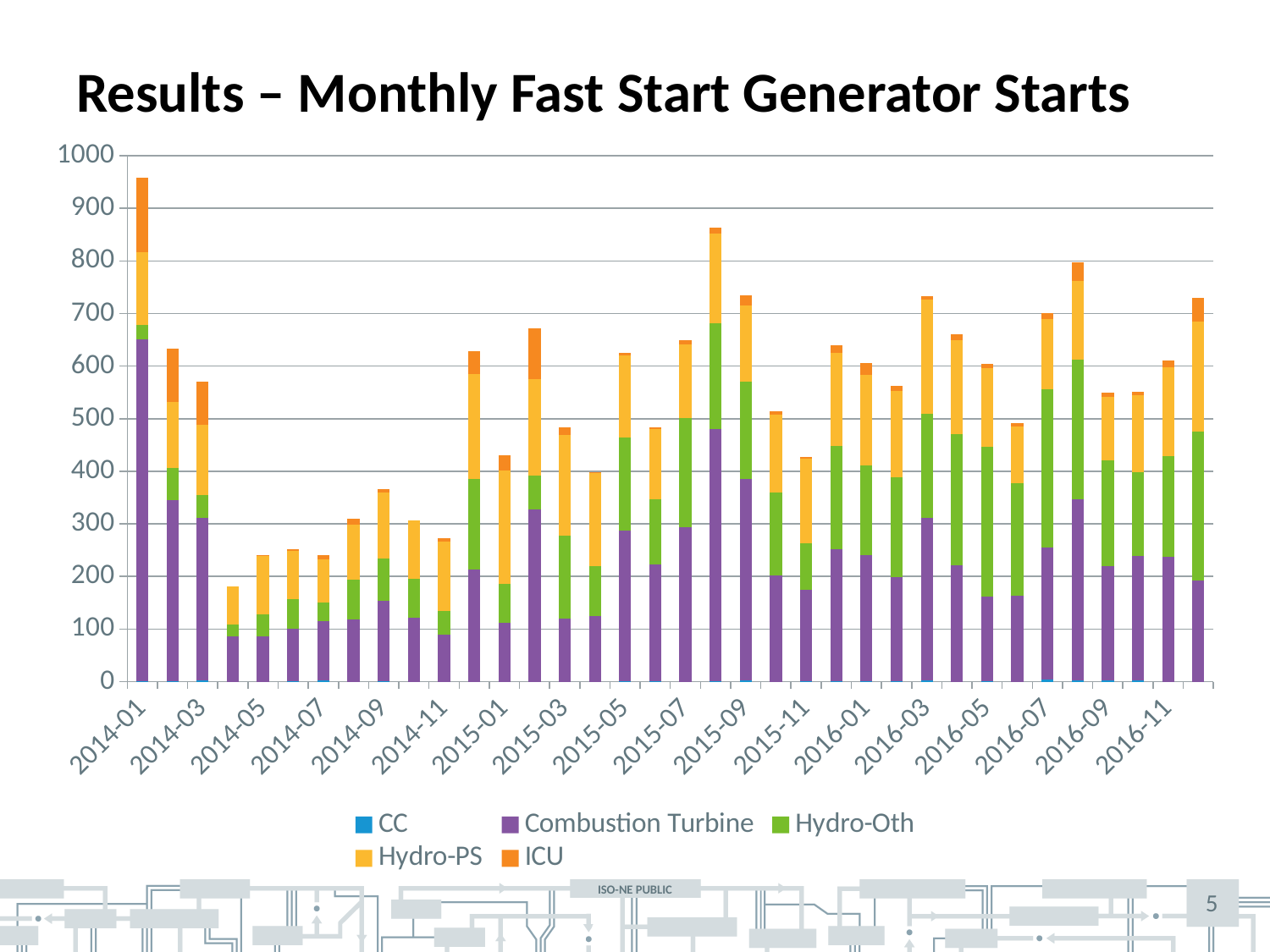
Is the total for 2015-09 greater or less than 700? greater How many month labels are shown on the x axis? 18 Which has the larger total, 2014-01 or 2014-03? 2014-01 What is the title of the chart on the slide? Results – Monthly Fast Start Generator Starts Which month has the tallest stacked bar? 2014-01 Is the total for 2015-11 greater or less than 500? less Is the total for 2014-01 greater or less than 900? greater Which series is shown in orange in the legend? ICU What kind of chart is shown on the slide? Stacked bar chart How many series does the legend list? 5